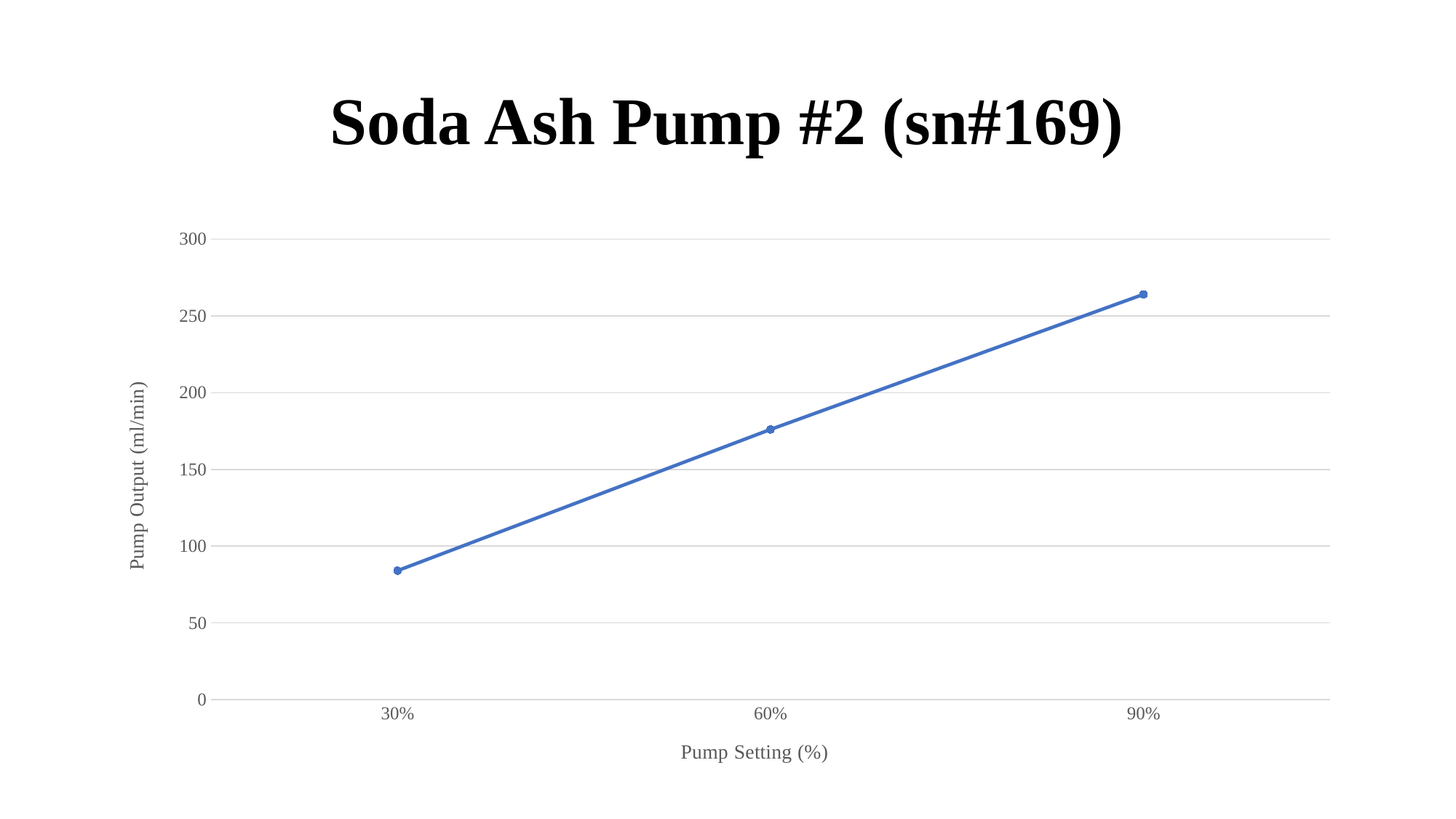
Is the pump output at the 90% setting greater or less than 250? greater What is the label of the y axis? Pump Output (ml/min) How many data points are plotted on the line? 3 What kind of chart is shown on the slide? line chart Is the pump output at the 60% setting greater or less than 200? less Does the pump output rise or fall as the pump setting increases from 30% to 90%? rise Which pump setting has the highest pump output? 90% Is the pump output at the 30% setting greater or less than 100? less Which pump setting has the lowest pump output? 30% Which has the larger pump output, the 30% setting or the 60% setting? 60% What is the title of the chart? Soda Ash Pump #2 (sn#169)